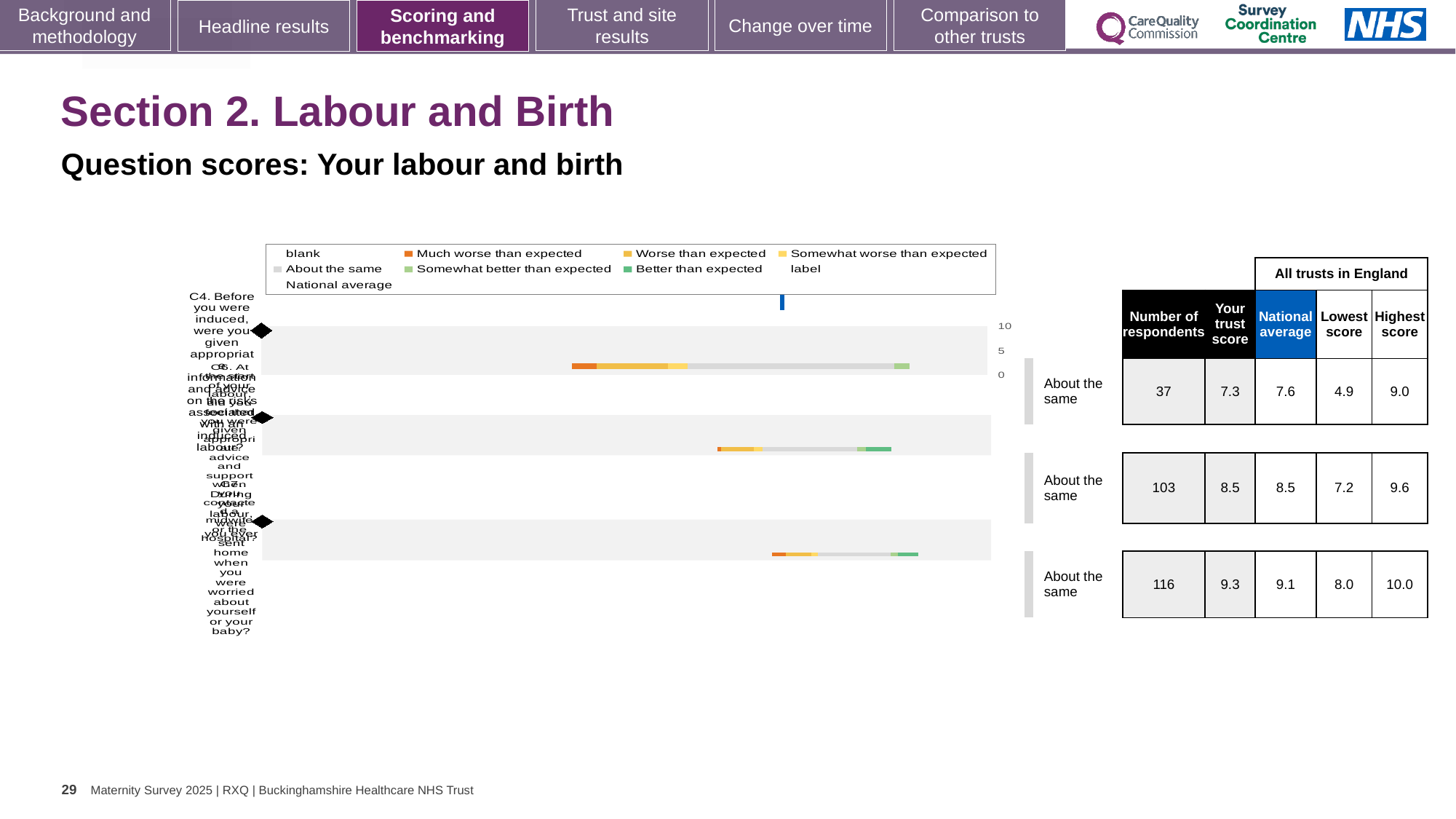
For the first (top) question row, which is larger: the trust score or the national average? the national average (7.6) What is the highest score among all trusts in England for the third (bottom) question row? 10.0 What is the trust score for the second question row? 8.5 What is the number of respondents for the first (top) question row? 37 What kind of chart is shown on the slide? bar chart For the first (top) question row, what is the difference between the highest score and the lowest score? 4.1 What is the national average for the third (bottom) question row? 9.1 Which question row has the lowest number of respondents? the first (top) row, 37 Is the trust score for the first (top) question row greater or less than 5? greater Which question row has the highest trust score? the third (bottom) row, 9.3 What benchmark category is shown for all three question rows? About the same How many question rows are plotted in the chart? 3